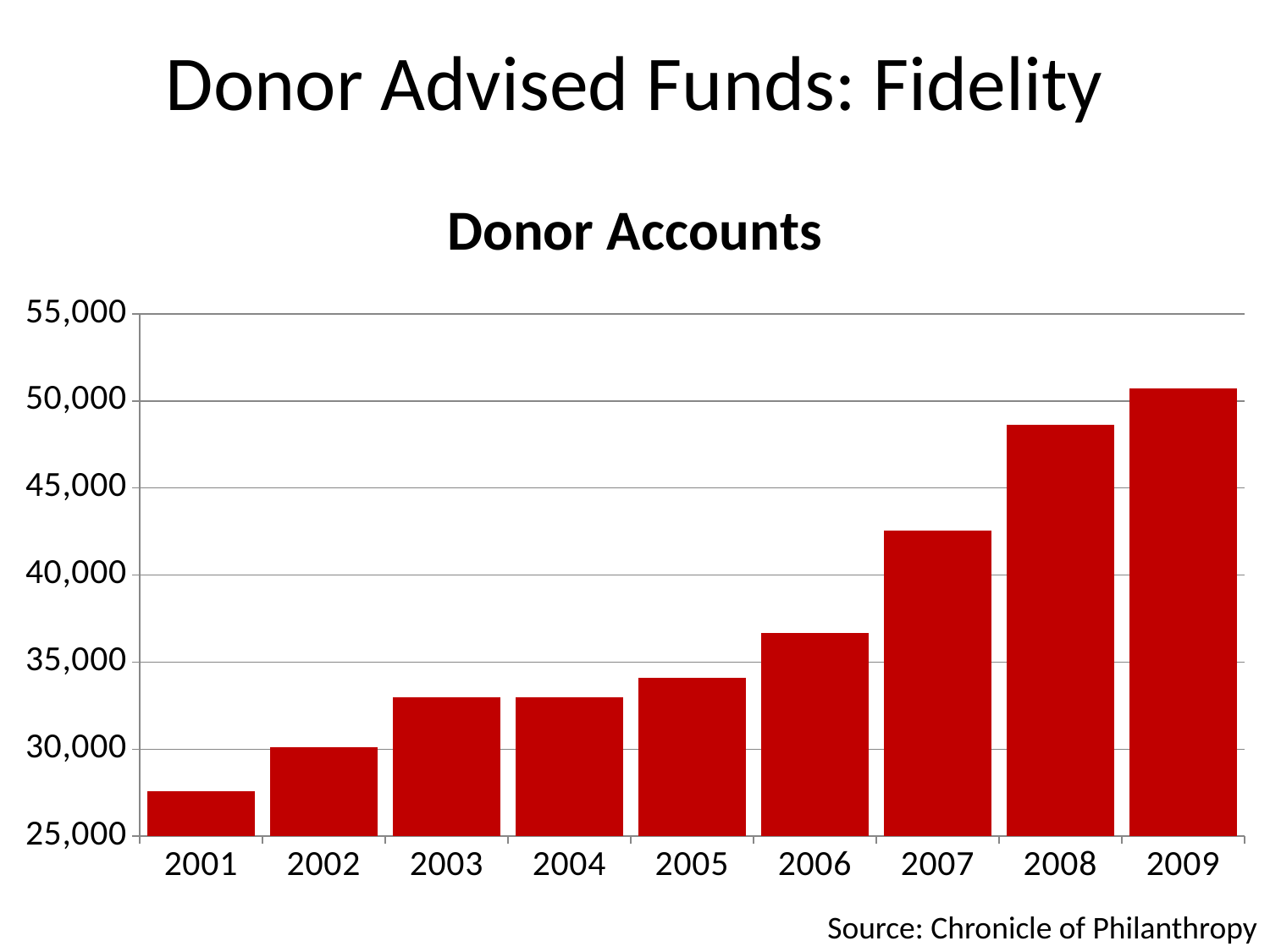
Which year has more donor accounts, 2005 or 2007? 2007 What is the title of the chart? Donor Accounts Is the value for 2001 greater or less than 30,000? less Which year has the lowest number of donor accounts? 2001 Do the donor account values generally rise or fall from 2001 to 2009? rise Is the value for 2007 greater or less than 40,000? greater Is the value for 2009 greater or less than 50,000? greater Which year has the highest number of donor accounts? 2009 How many years are shown on the x axis of the chart? 9 What type of chart is shown on the slide? bar chart